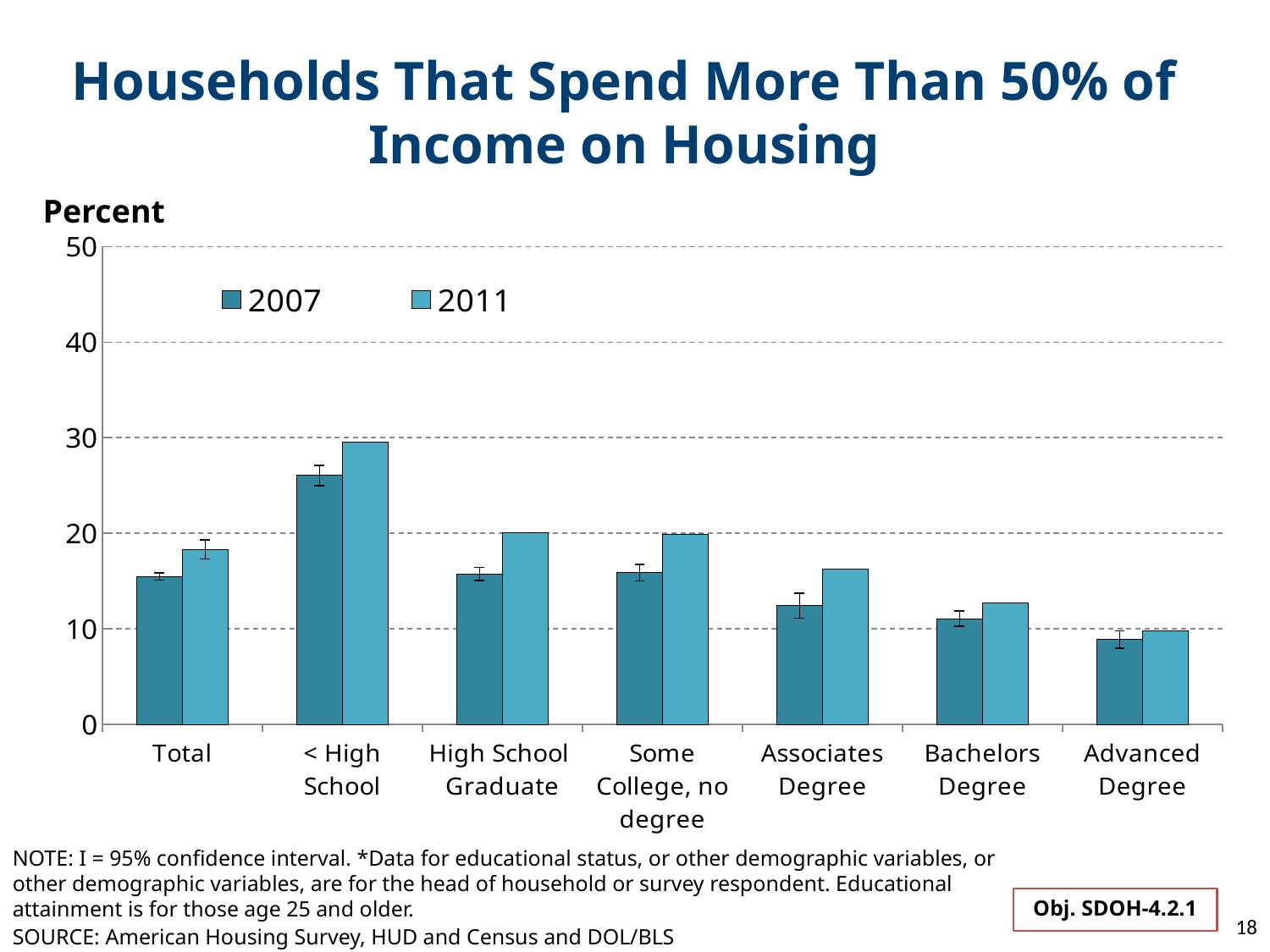
What kind of chart is shown on the slide? bar chart Which category has the highest value for 2011? < High School How many series does the legend list? 2 What label is shown above the vertical axis? Percent Moving from < High School to Advanced Degree along the x axis, do the 2011 values generally rise or fall? fall Is the 2007 value for Advanced Degree greater or less than 10? less Is the 2007 value for Associates Degree greater or less than 10? greater How many education categories are shown on the x axis? 7 Which category has the lowest value for 2007? Advanced Degree Is the 2011 value for < High School greater or less than 20? greater For the Total category, which year has the larger value, 2007 or 2011? 2011